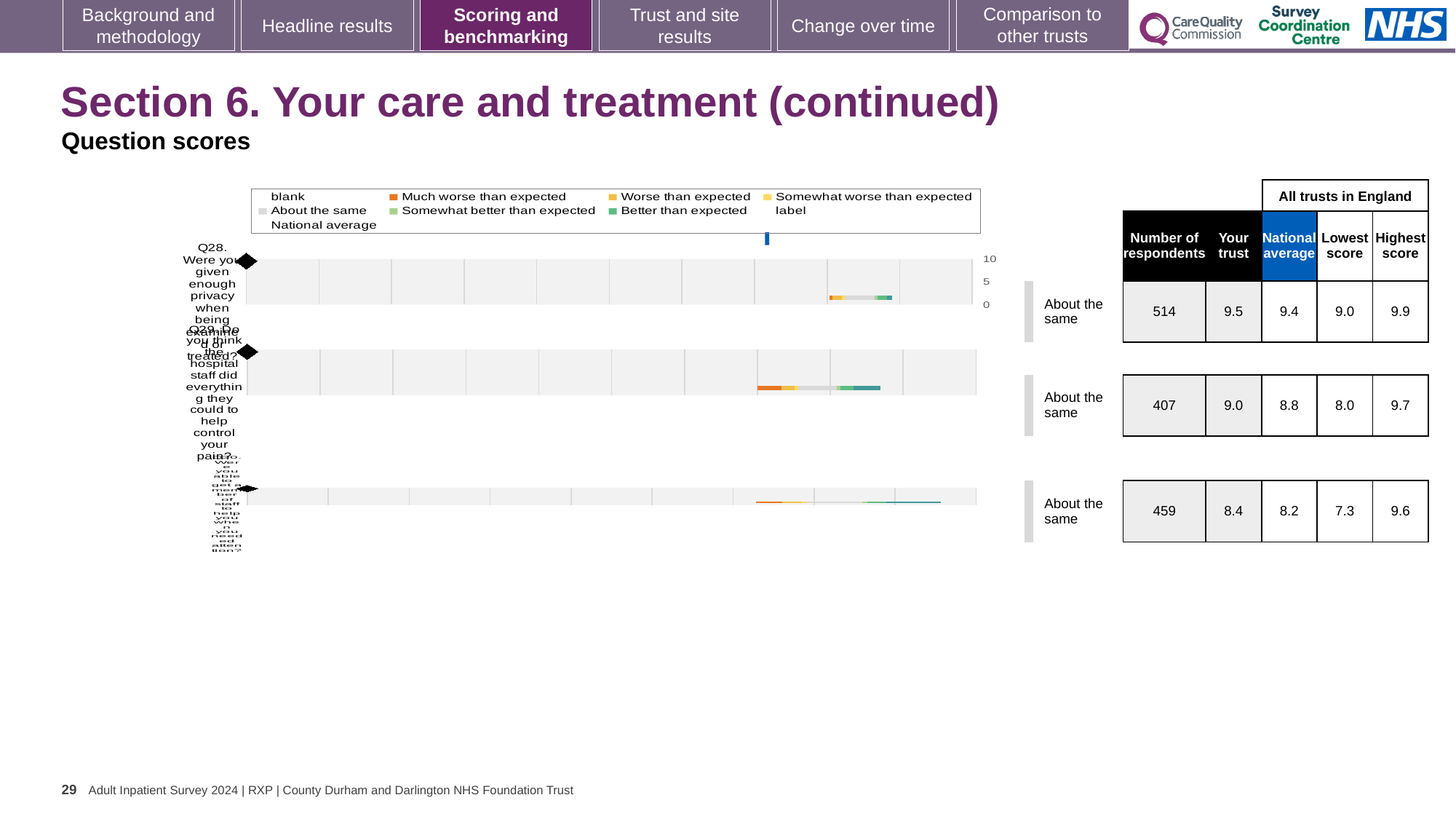
How many questions (rows) are plotted in the chart? 3 Which of the three questions has the lowest national average score? Q30 What is the 'Your trust' score for Q28 (Were you given enough privacy when being examined or treated?)? 9.5 Is the 'Your trust' score for Q28 higher or lower than the national average for Q28? higher What is the lowest score among all trusts in England for Q29? 8.0 What is the highest score among all trusts in England for the third question (Q30)? 9.6 What benchmark category is shown for Q28? About the same What is the difference between the 'Your trust' score and the national average for Q29? 0.2 What kind of chart is shown on the slide? bar chart What is the national average score for Q29 (Do you think the hospital staff did everything they could to help control your pain?)? 8.8 Which of the three questions has the highest 'Your trust' score? Q28 How many respondents answered Q28? 514